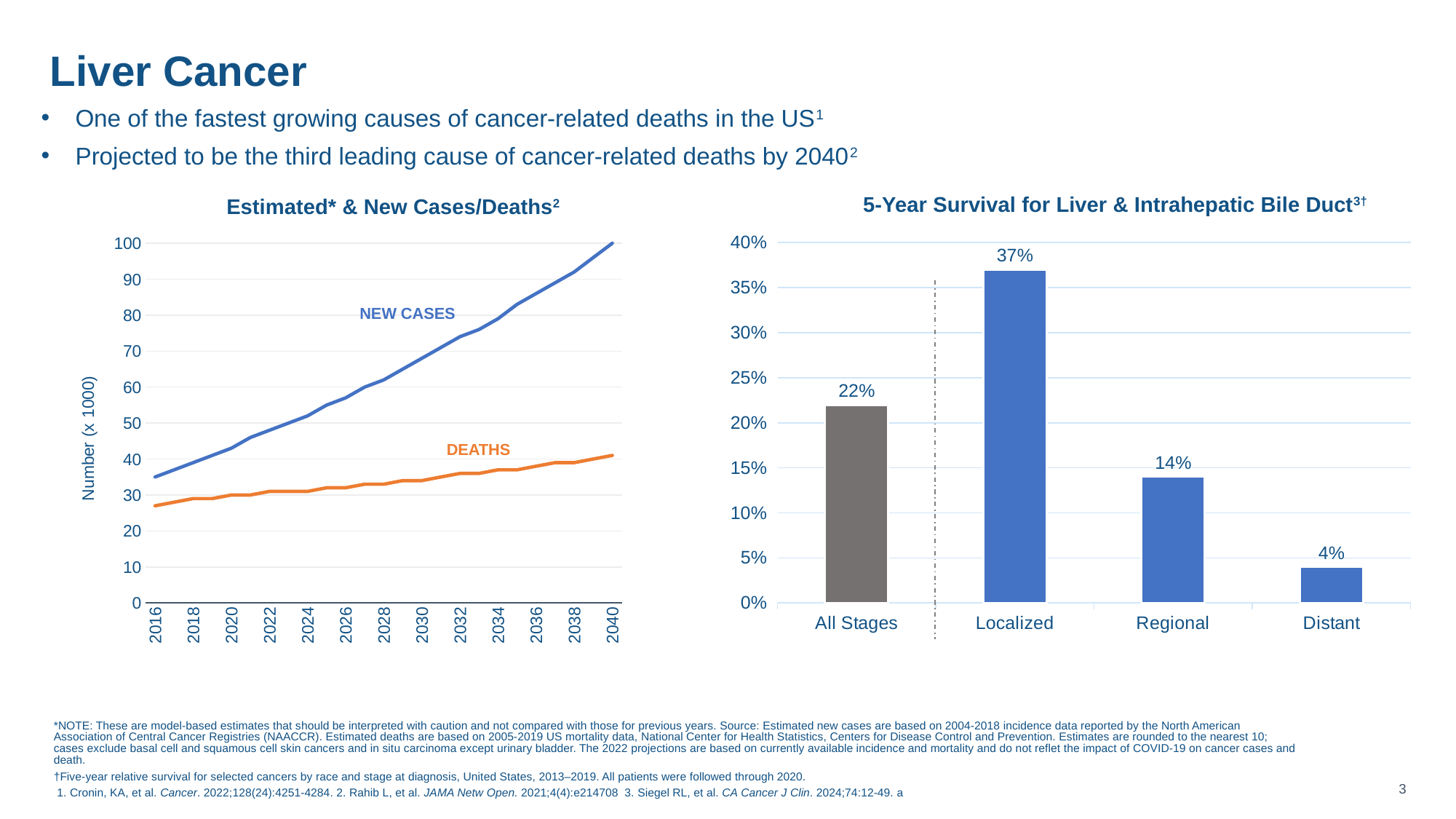
In the 5-Year Survival for Liver & Intrahepatic Bile Duct chart, which stage has the lowest 5-year survival? Distant How many bars are shown in the 5-Year Survival for Liver & Intrahepatic Bile Duct chart? 4 In the Estimated* & New Cases/Deaths chart, is the value for DEATHS in 2040 greater or less than 50? less In the 5-Year Survival for Liver & Intrahepatic Bile Duct chart, what is the 5-year survival for Distant? 4% In the 5-Year Survival for Liver & Intrahepatic Bile Duct chart, what is the 5-year survival for Localized? 37% In the 5-Year Survival for Liver & Intrahepatic Bile Duct chart, what is the 5-year survival for All Stages? 22% What kind of chart is the 5-Year Survival for Liver & Intrahepatic Bile Duct chart? Bar chart In the Estimated* & New Cases/Deaths chart, do new cases rise or fall from 2016 to 2040? Rise What kind of chart is the Estimated* & New Cases/Deaths chart? Line chart In the 5-Year Survival for Liver & Intrahepatic Bile Duct chart, which stage has the highest 5-year survival? Localized In the 5-Year Survival for Liver & Intrahepatic Bile Duct chart, which is larger, the survival rate for All Stages or for Regional? All Stages In the 5-Year Survival for Liver & Intrahepatic Bile Duct chart, what is the difference between the Localized and Regional survival rates? 23%